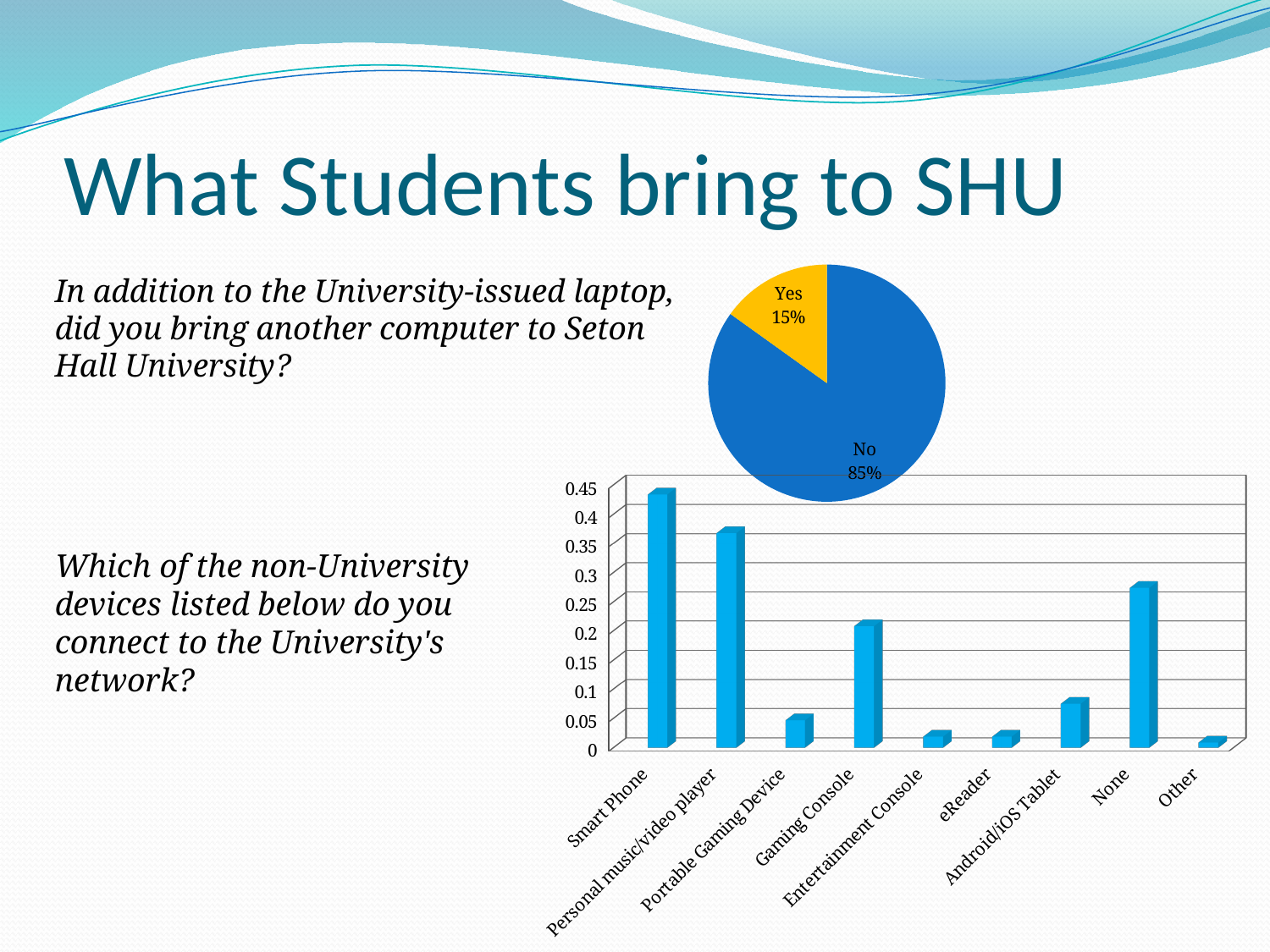
In the bar chart, is the value for Smart Phone greater or less than 0.4? greater In the pie chart, what percentage of students answered No? 85% What kind of chart is the lower chart about non-University devices? bar chart In the pie chart, which answer has the larger share, Yes or No? No In the bar chart, is the value for Portable Gaming Device greater or less than 0.1? less In the bar chart, which is larger, the value for None or the value for Gaming Console? None In the bar chart, which category has the highest value? Smart Phone In the pie chart, how many slices are there? 2 In the bar chart, is the value for Gaming Console greater or less than 0.25? less In the pie chart, what percentage of students answered Yes? 15% In the pie chart, how many percentage points larger is the No share than the Yes share? 70 In the bar chart, how many device categories are shown on the x axis? 9